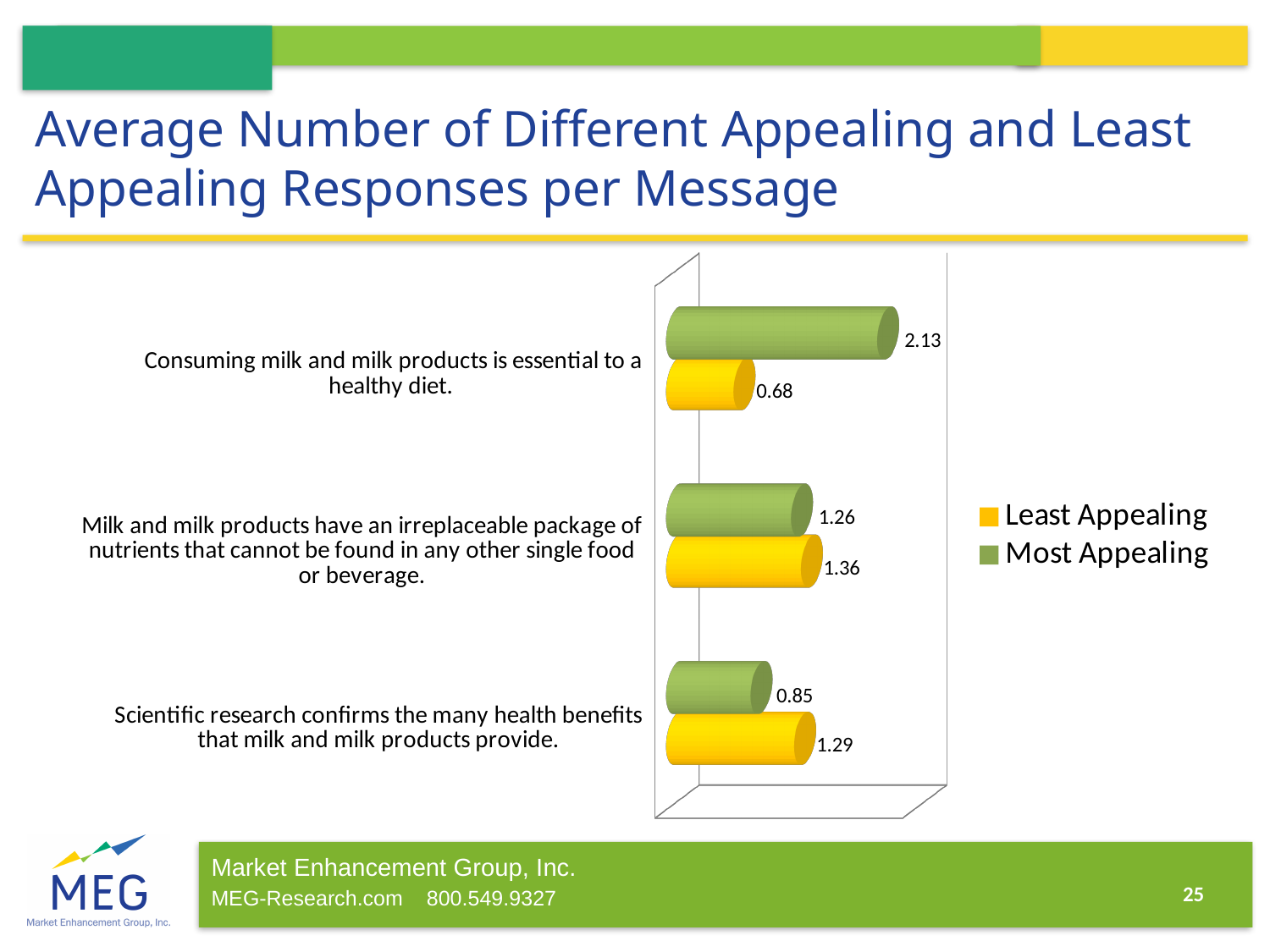
What is the Most Appealing value for the message "Consuming milk and milk products is essential to a healthy diet."? 2.13 Which message has the lowest Least Appealing value? Consuming milk and milk products is essential to a healthy diet. For the message "Scientific research confirms the many health benefits that milk and milk products provide.", which is larger: the Most Appealing or the Least Appealing value? Least Appealing What is the Least Appealing value for the message "Milk and milk products have an irreplaceable package of nutrients that cannot be found in any other single food or beverage."? 1.36 Which colour represents the Least Appealing series in the chart? Yellow What is the Most Appealing value for the message "Scientific research confirms the many health benefits that milk and milk products provide."? 0.85 Which message has the highest Most Appealing value? Consuming milk and milk products is essential to a healthy diet. What is the difference between the Most Appealing and Least Appealing values for the message "Consuming milk and milk products is essential to a healthy diet."? 1.45 How many messages (categories) are shown in the chart? 3 How many series does the legend list? 2 What is the Least Appealing value for the message "Consuming milk and milk products is essential to a healthy diet."? 0.68 What kind of chart is shown on the slide? Bar chart